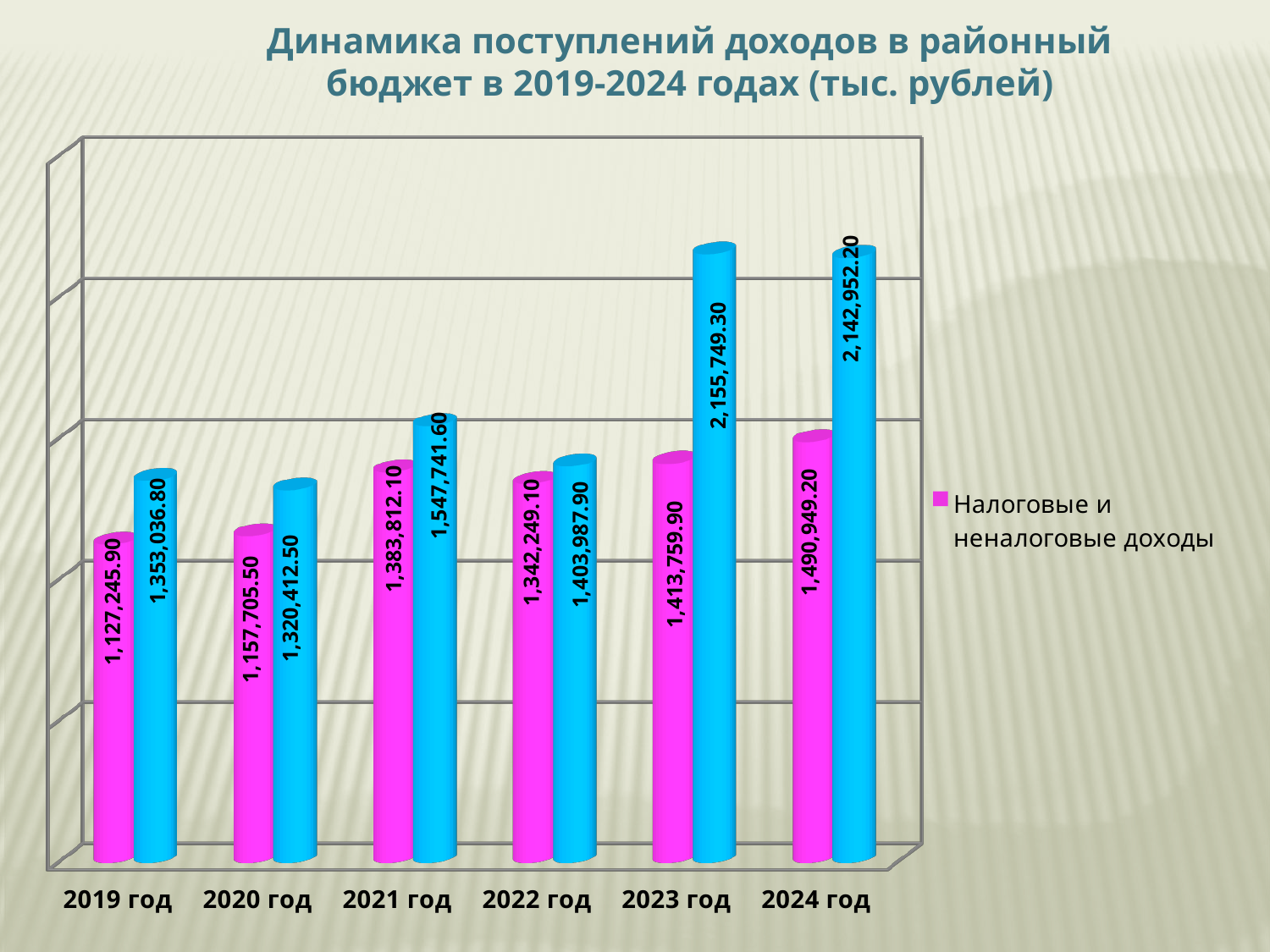
In which year is the blue series highest? 2023 год Which year has the larger value of Налоговые и неналоговые доходы, 2021 год or 2022 год? 2021 год How many years are shown on the x axis? 6 What is the value of the blue series for 2023 год? 2,155,749.30 What kind of chart is shown on the slide? Bar chart What is the difference between the blue series values for 2023 год and 2022 год? 751,761.40 What is the value of Налоговые и неналоговые доходы for 2019 год? 1,127,245.90 In which year is Налоговые и неналоговые доходы highest? 2024 год What is the difference between Налоговые и неналоговые доходы in 2024 год and in 2019 год? 363,703.30 What is the value of Налоговые и неналоговые доходы for 2024 год? 1,490,949.20 In which year is Налоговые и неналоговые доходы lowest? 2019 год In which year is the blue series lowest? 2020 год